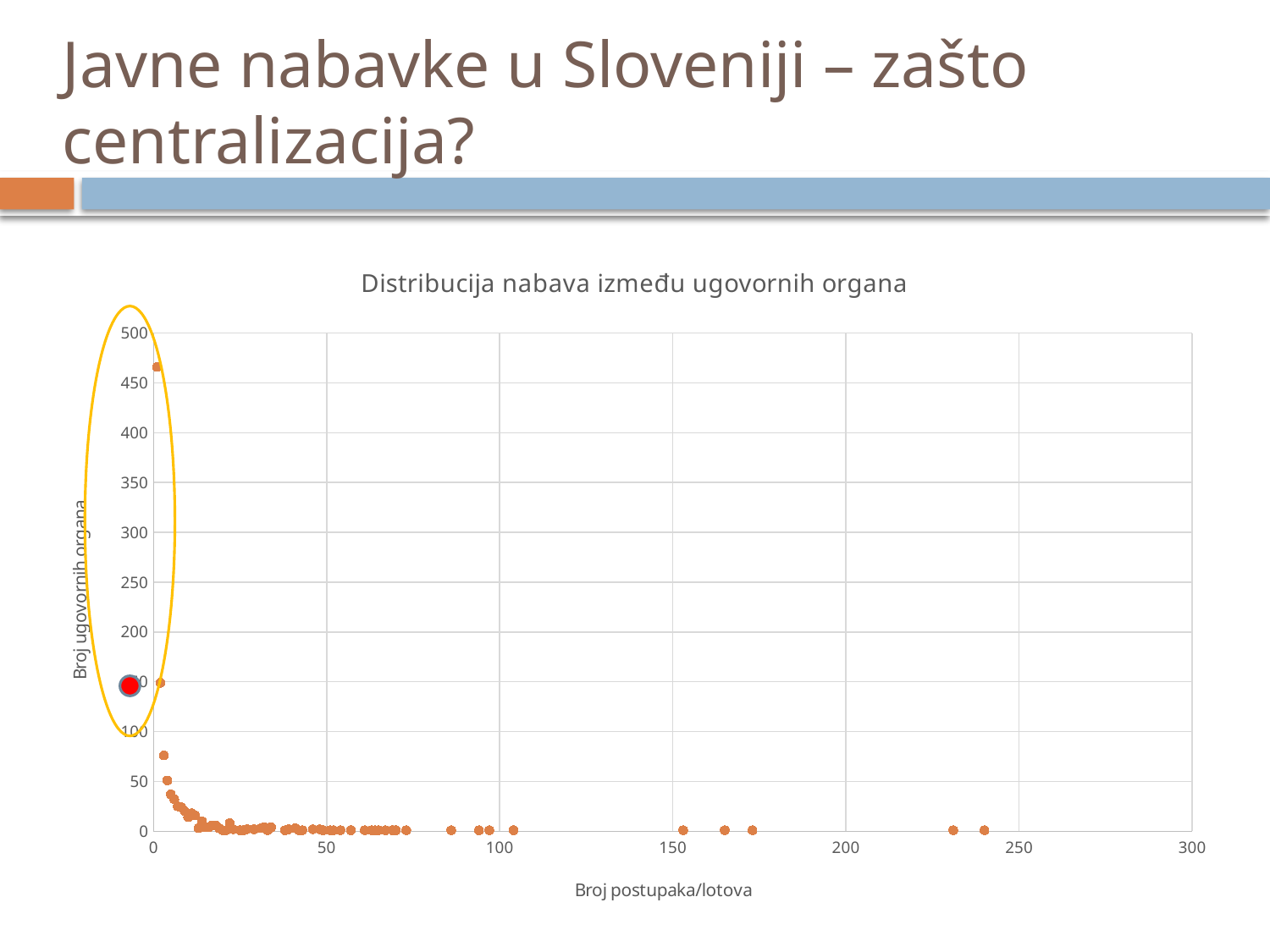
Is the highest point on the chart greater or less than 500 on the y axis? less What is the label of the x axis? Broj postupaka/lotova Is the highest point on the chart greater or less than 450 on the y axis? greater What is the title of the chart? Distribucija nabava između ugovornih organa Is the second-highest point on the chart greater or less than 100 on the y axis? greater What is the highest tick value shown on the x axis? 300 Do the y values rise or fall as the x values increase along the x axis? fall What kind of chart is shown on the slide? scatter chart